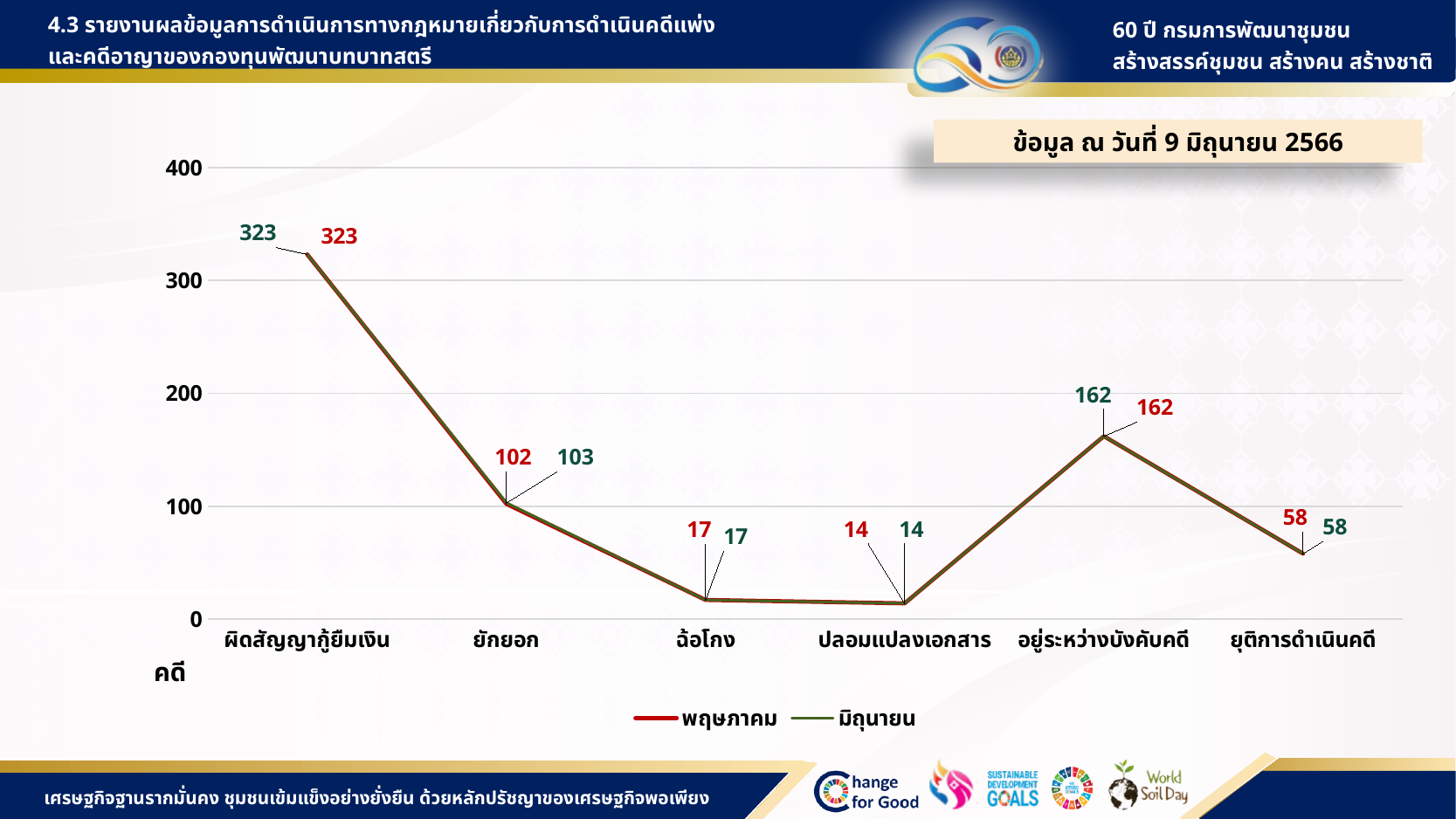
What is the value for อยู่ระหว่างบังคับคดี in the มิถุนายน series? 162 What is the value for ยักยอก in the พฤษภาคม series? 102 Which series is drawn in red according to the legend? พฤษภาคม How many categories are shown on the x axis? 6 What is the value for ยุติการดำเนินคดี in the พฤษภาคม series? 58 Which is larger in the มิถุนายน series: ฉ้อโกง or ยุติการดำเนินคดี? ยุติการดำเนินคดี How many series does the legend list? 2 What is the value for ยักยอก in the มิถุนายน series? 103 What is the difference between the พฤษภาคม values for ผิดสัญญากู้ยืมเงิน and อยู่ระหว่างบังคับคดี? 161 Which category has the highest value in the พฤษภาคม series? ผิดสัญญากู้ยืมเงิน What type of chart is shown on the slide? line chart Which category has the lowest value in the มิถุนายน series? ปลอมแปลงเอกสาร